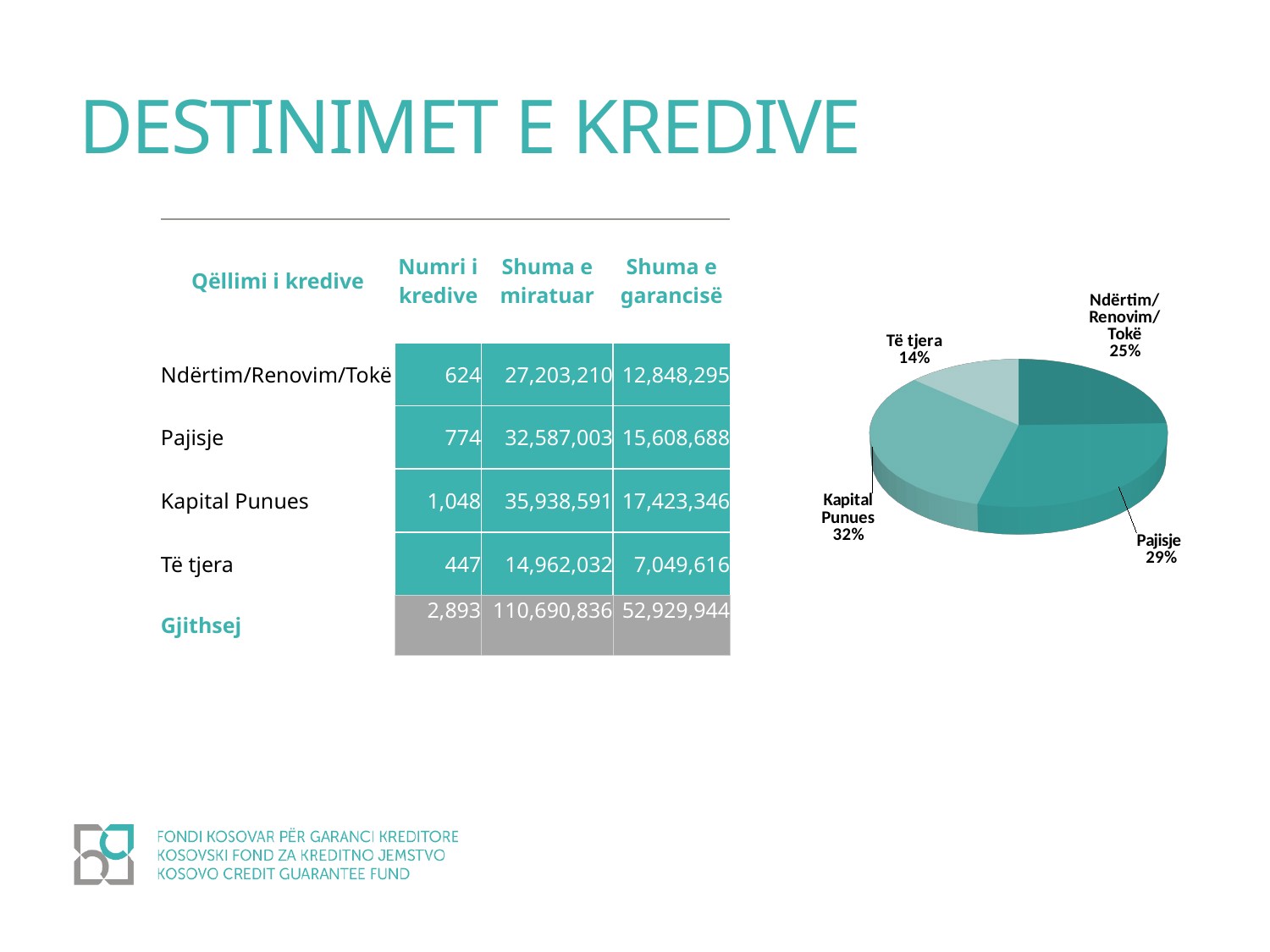
What share of the pie chart does Pajisje represent? 29% Which slice of the pie chart is the smallest? Të tjera What share of the pie chart does Të tjera represent? 14% What share of the pie chart does Ndërtim/Renovim/Tokë represent? 25% What type of chart is shown on the slide? pie chart In the pie chart, which is larger: Pajisje or Ndërtim/Renovim/Tokë? Pajisje In the pie chart, what is the difference in percentage points between Pajisje and Ndërtim/Renovim/Tokë? 4 Which slice of the pie chart is the largest? Kapital Punues Is the pie chart drawn in 3D? yes How many slices does the pie chart have? 4 In the pie chart, what is the difference in percentage points between Kapital Punues and Të tjera? 18